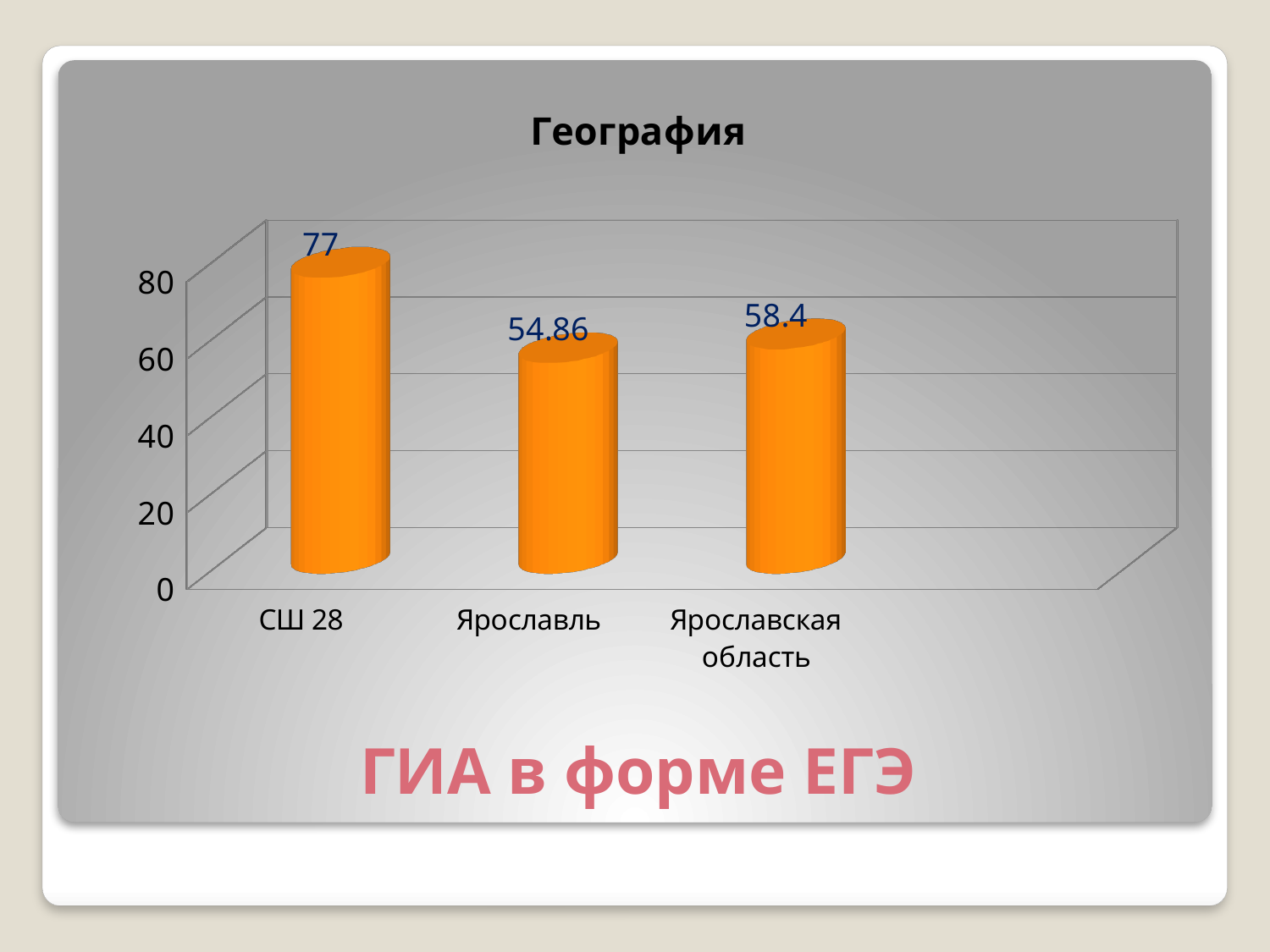
What is the title of the chart? География What is the value for Ярославль? 54.86 Is the value for Ярославль greater or less than 60? less What is the difference between the values for СШ 28 and Ярославская область? 18.6 What is the value for Ярославская область? 58.4 What is the value for СШ 28? 77 What is the difference between the values for Ярославская область and Ярославль? 3.54 Which is larger, the value for Ярославль or the value for Ярославская область? Ярославская область How many categories are shown on the chart? 3 Which category has the highest value? СШ 28 Which category has the lowest value? Ярославль What kind of chart is shown on the slide? bar chart